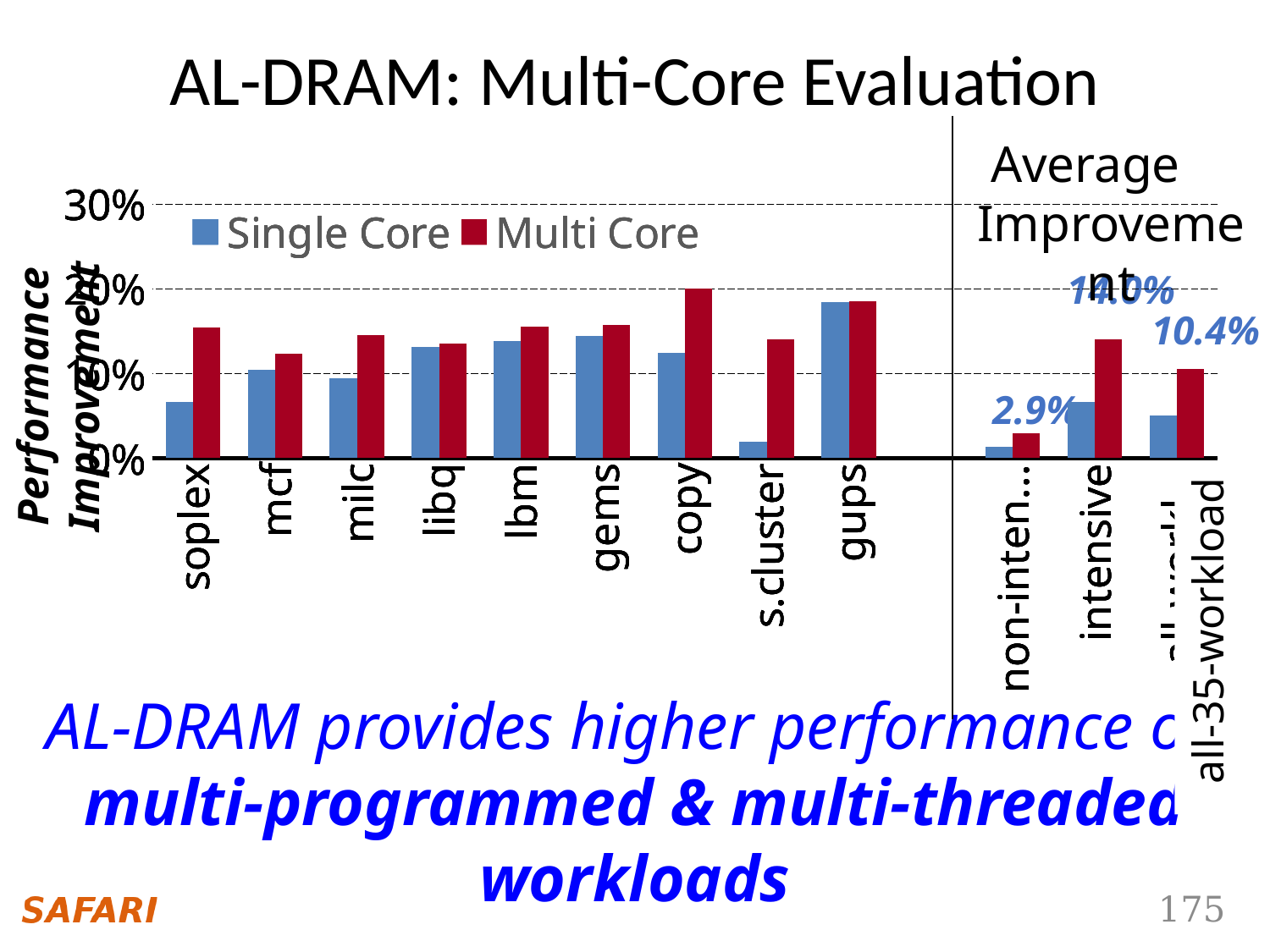
How many series does the legend list? 2 What is the title of the slide's chart? AL-DRAM: Multi-Core Evaluation Is the Multi Core value for copy greater or less than 10%? greater What kind of chart is shown on the slide? bar chart What are the two series named in the legend? Single Core and Multi Core Which category has the lowest Multi Core value? non-intensive What is the labelled Multi Core value for the non-intensive category? 2.9% For copy, which is larger: the Single Core value or the Multi Core value? Multi Core What is the difference between the labelled Multi Core values for all-35-workload and non-intensive? 7.5% Which category has the highest Single Core value? gups Is the Single Core value for s.cluster greater or less than 10%? less What is the labelled Multi Core value for the all-35-workload category? 10.4%